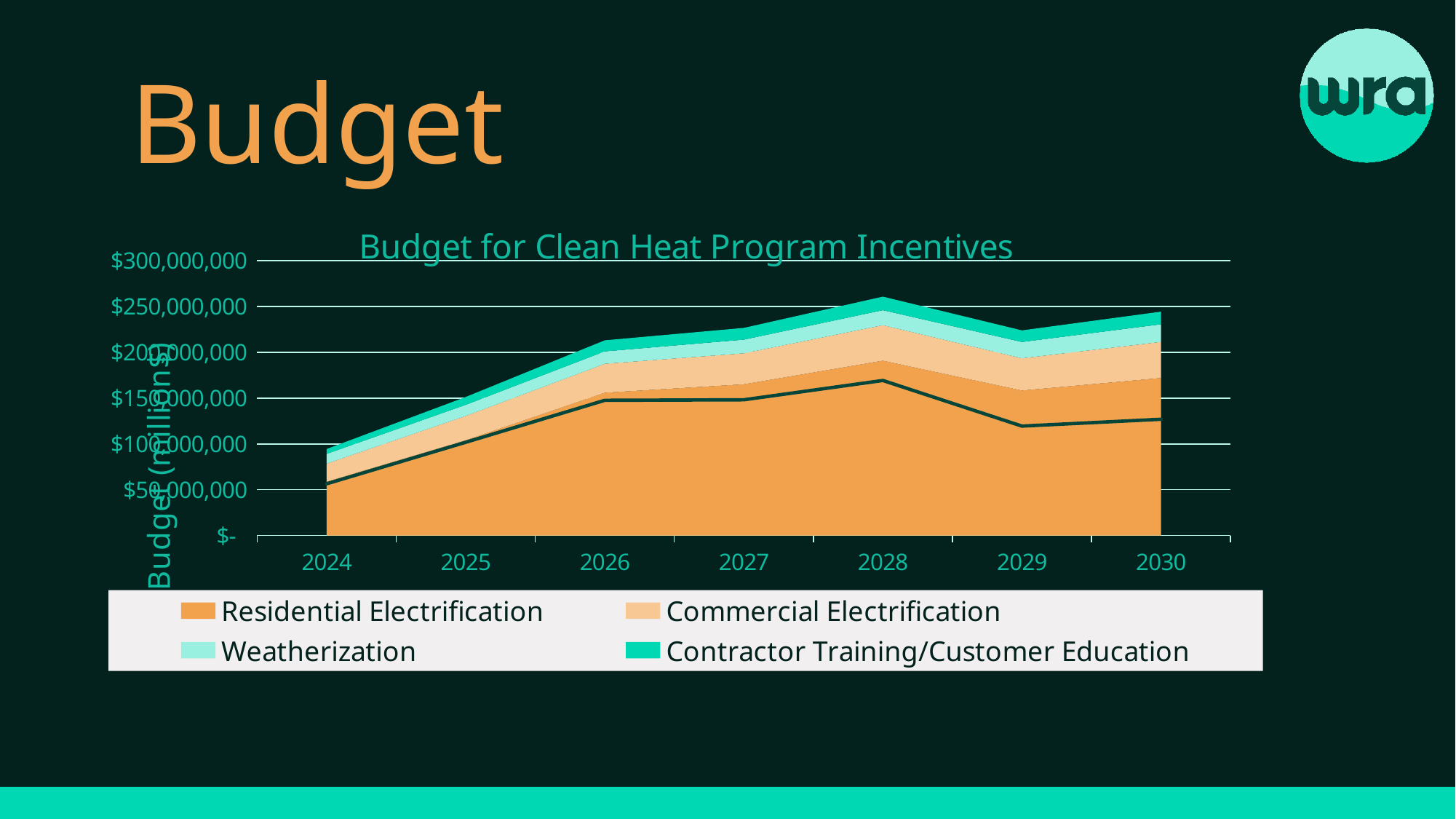
How many years are plotted along the x axis? 7 What is the title of the chart? Budget for Clean Heat Program Incentives Which series is shown in the darkest orange colour at the bottom of the stack? Residential Electrification Is the Residential Electrification value for 2028 greater or less than $150,000,000? greater Which year has the larger Residential Electrification budget, 2024 or 2026? 2026 In which year is the Residential Electrification budget highest? 2028 Does the Residential Electrification budget rise or fall from 2024 to 2026? rise Is the Residential Electrification value for 2024 greater or less than $100,000,000? less Is the total stacked budget for 2026 greater or less than $200,000,000? greater How many series does the legend list? 4 What kind of chart is shown on the slide? Stacked area chart with a line overlay In which year is the Residential Electrification budget lowest? 2024